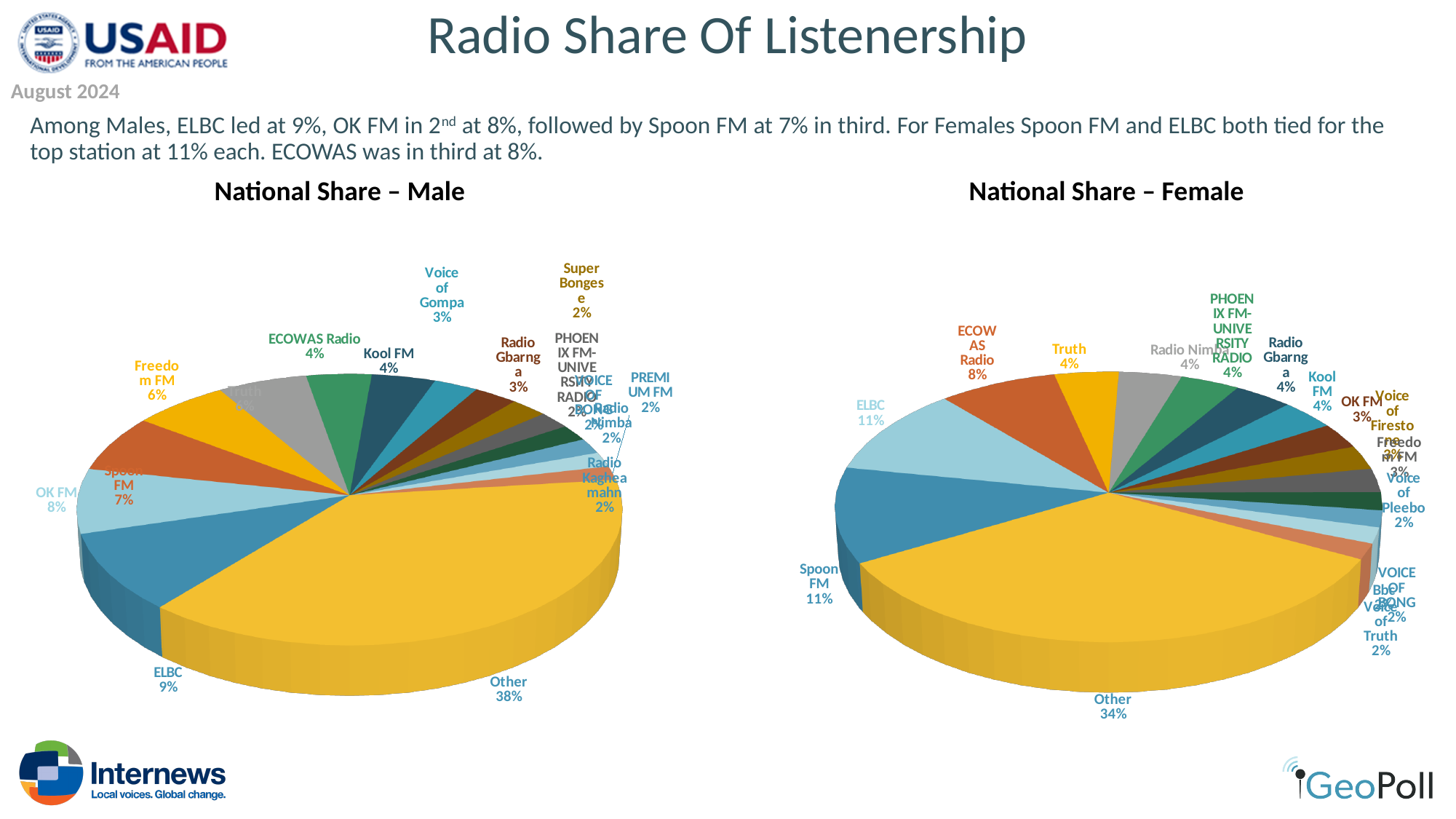
In the National Share – Male chart, what share does Freedom FM have? 6% In the National Share – Male chart, what is the difference between the shares of ELBC and Spoon FM? 2% In the National Share – Female chart, what share does Other have? 34% In the National Share – Male chart, which slice is the largest? Other What is the title of the pie chart on the right side of the slide? National Share – Female In the National Share – Female chart, what share does Spoon FM have? 11% In the National Share – Female chart, which is larger, the share of ECOWAS Radio or the share of Kool FM? ECOWAS Radio In the National Share – Male chart, what share does ELBC have? 9% What type of charts are shown on the slide? Pie charts In the National Share – Female chart, what share does ECOWAS Radio have? 8% In the National Share – Male chart, what share does Other have? 38% In the National Share – Male chart, what share does OK FM have? 8%